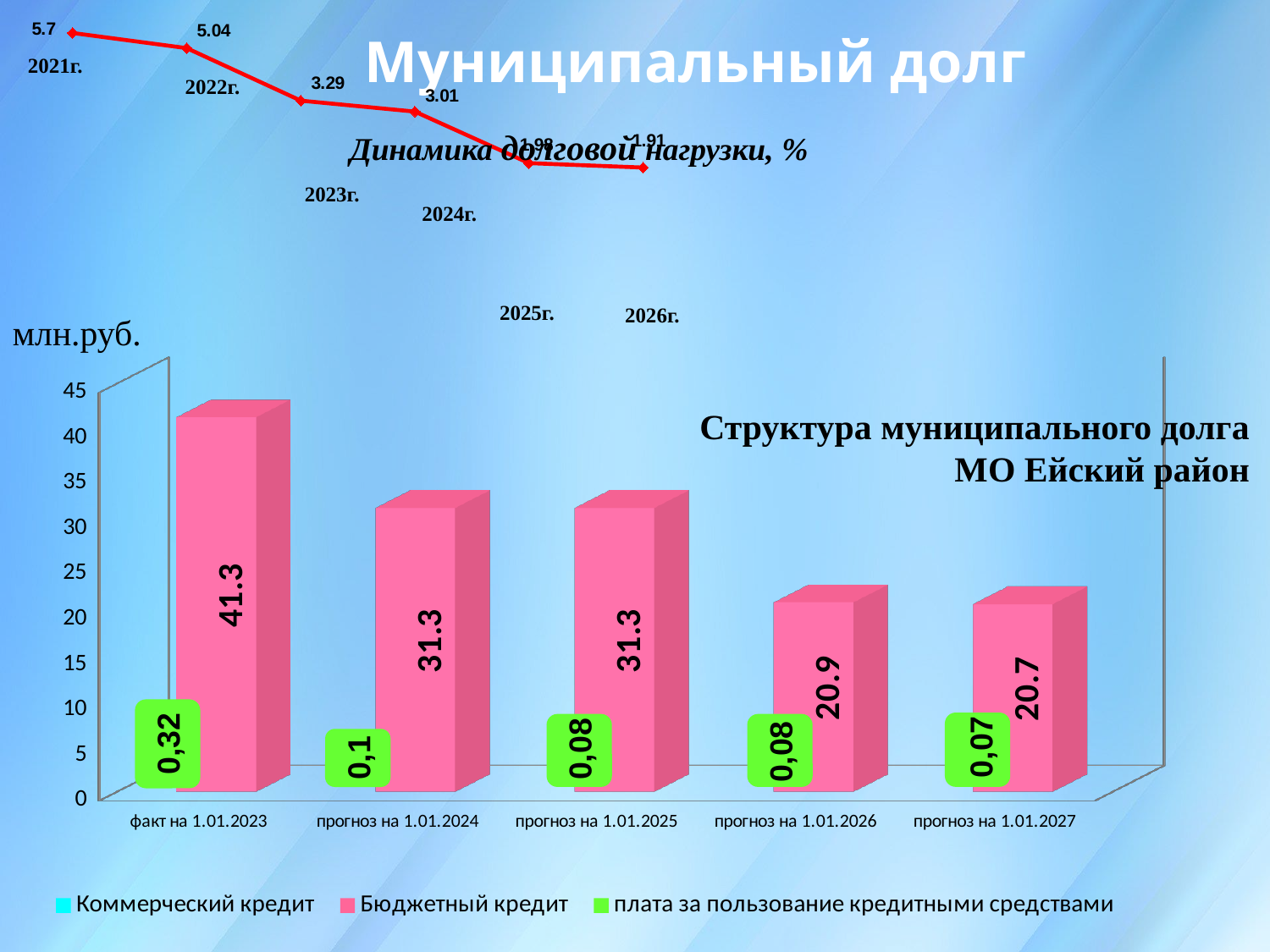
In the line chart 'Динамика долговой нагрузки, %', what is the value for 2021г.? 5.7 In the bar chart 'Структура муниципального долга МО Ейский район', how many series does the legend list? 3 In the bar chart 'Структура муниципального долга МО Ейский район', what is the value of Бюджетный кредит for факт на 1.01.2023? 41.3 In the bar chart 'Структура муниципального долга МО Ейский район', what is the difference in Бюджетный кредит between факт на 1.01.2023 and прогноз на 1.01.2024? 10.0 In the bar chart 'Структура муниципального долга МО Ейский район', which category has the lowest Бюджетный кредит value? прогноз на 1.01.2027 In the bar chart 'Структура муниципального долга МО Ейский район', how many categories are shown on the x axis? 5 In the line chart 'Динамика долговой нагрузки, %', what is the difference between the values for 2022г. and 2024г.? 2.03 In the line chart 'Динамика долговой нагрузки, %', what is the value for 2023г.? 3.29 In the line chart 'Динамика долговой нагрузки, %', which year has the highest value? 2021г. In the line chart 'Динамика долговой нагрузки, %', do the values rise or fall from 2021г. to 2026г.? fall What kind of chart is 'Структура муниципального долга МО Ейский район'? bar chart In the bar chart 'Структура муниципального долга МО Ейский район', what is the value of плата за пользование кредитными средствами for прогноз на 1.01.2027? 0,07